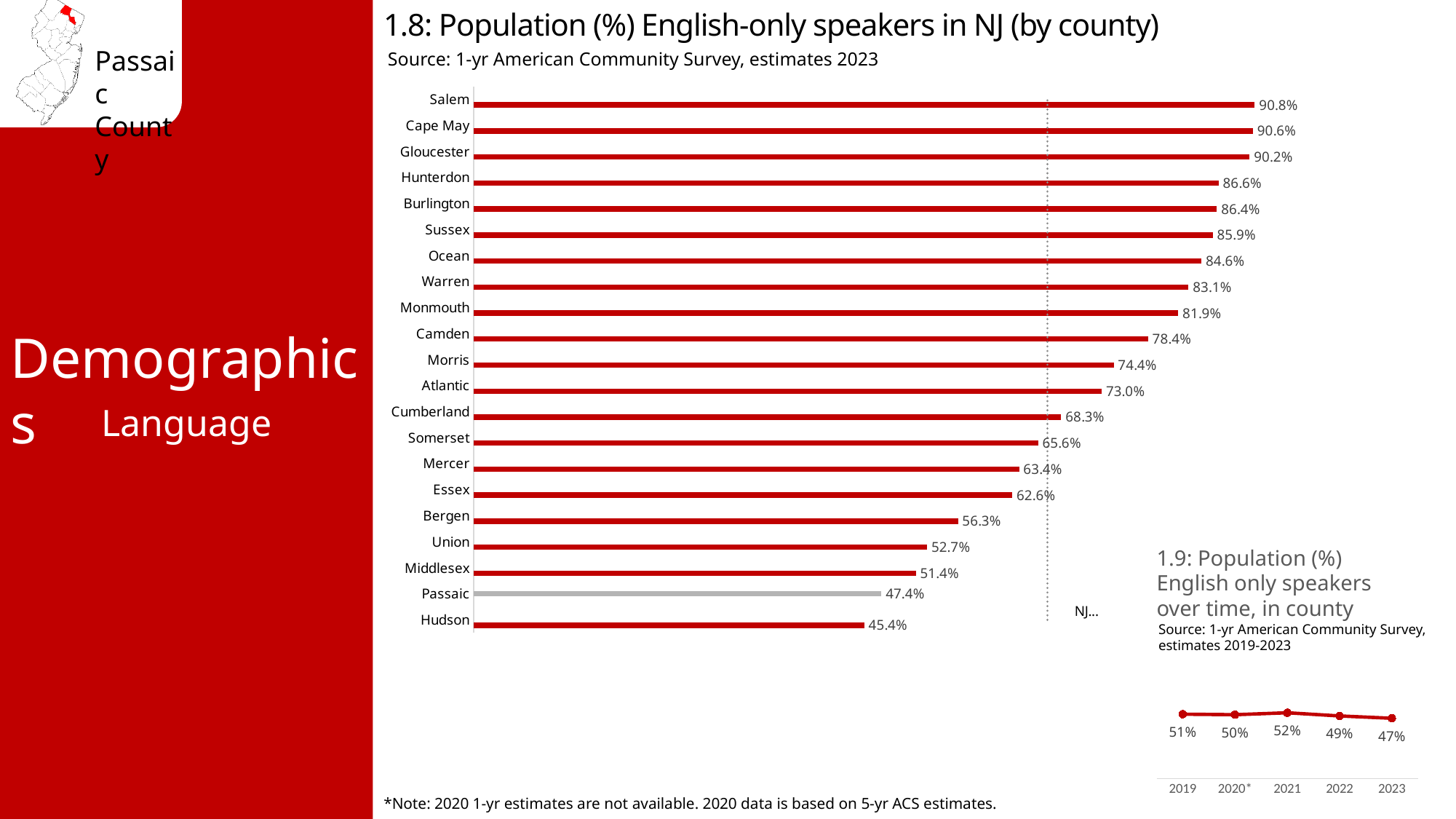
In chart 1.8, which county has the lowest percentage of English-only speakers? Hudson In chart 1.8, which bar is shown in grey instead of red? Passaic In chart 1.8, what is the difference between the values for Salem and Hudson? 45.4% In chart 1.9, how many years are plotted? 5 In chart 1.9, what is the value for 2021? 52% What kind of chart is chart 1.8? bar chart In chart 1.8, what is the value for Gloucester? 90.2% In chart 1.8, which county has the highest percentage of English-only speakers? Salem In chart 1.8, how many counties are plotted? 21 In chart 1.8, which is larger, the value for Bergen or the value for Union? Bergen In chart 1.9, what is the difference between the values for 2019 and 2023? 4% In chart 1.8, what is the value for Passaic? 47.4%